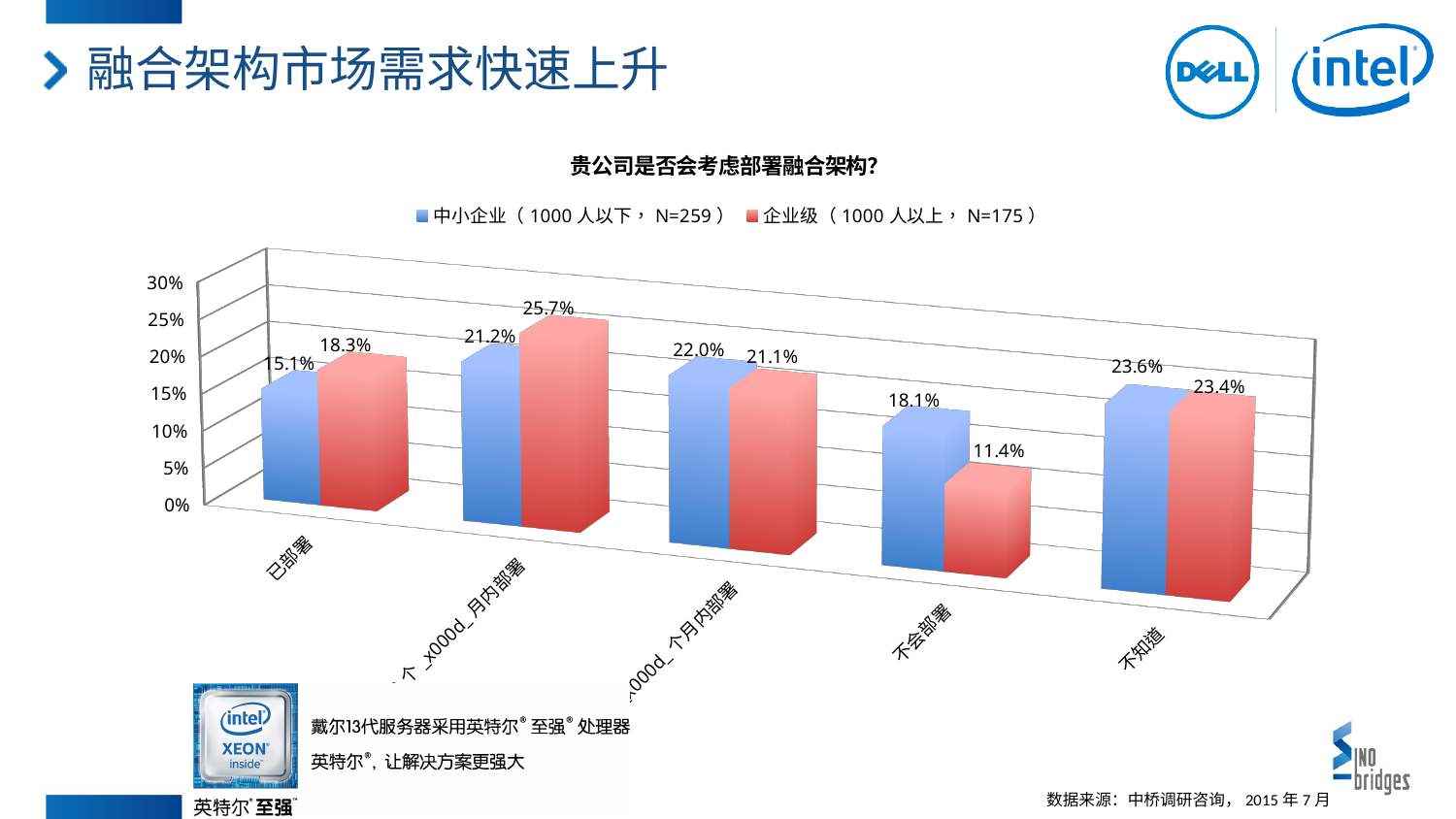
What is the value for 中小企业 in the 不知道 category? 23.6% How many series does the legend list? 2 Which category has the lowest value for the 企业级 series? 不会部署 What is the value for 企业级 in the 已部署 category? 18.3% In the 已部署 category, which series has the larger value, 中小企业 or 企业级? 企业级 What is the value for 企业级 in the 不知道 category? 23.4% What is the value for 中小企业 in the 已部署 category? 15.1% In the 不会部署 category, what is the difference between the 中小企业 value and the 企业级 value? 6.7 percentage points Which category has the highest value for the 中小企业 series? 不知道 What is the value for 企业级 in the 不会部署 category? 11.4% Which category has the lowest value for the 中小企业 series? 已部署 What kind of chart is shown on the slide? Bar chart